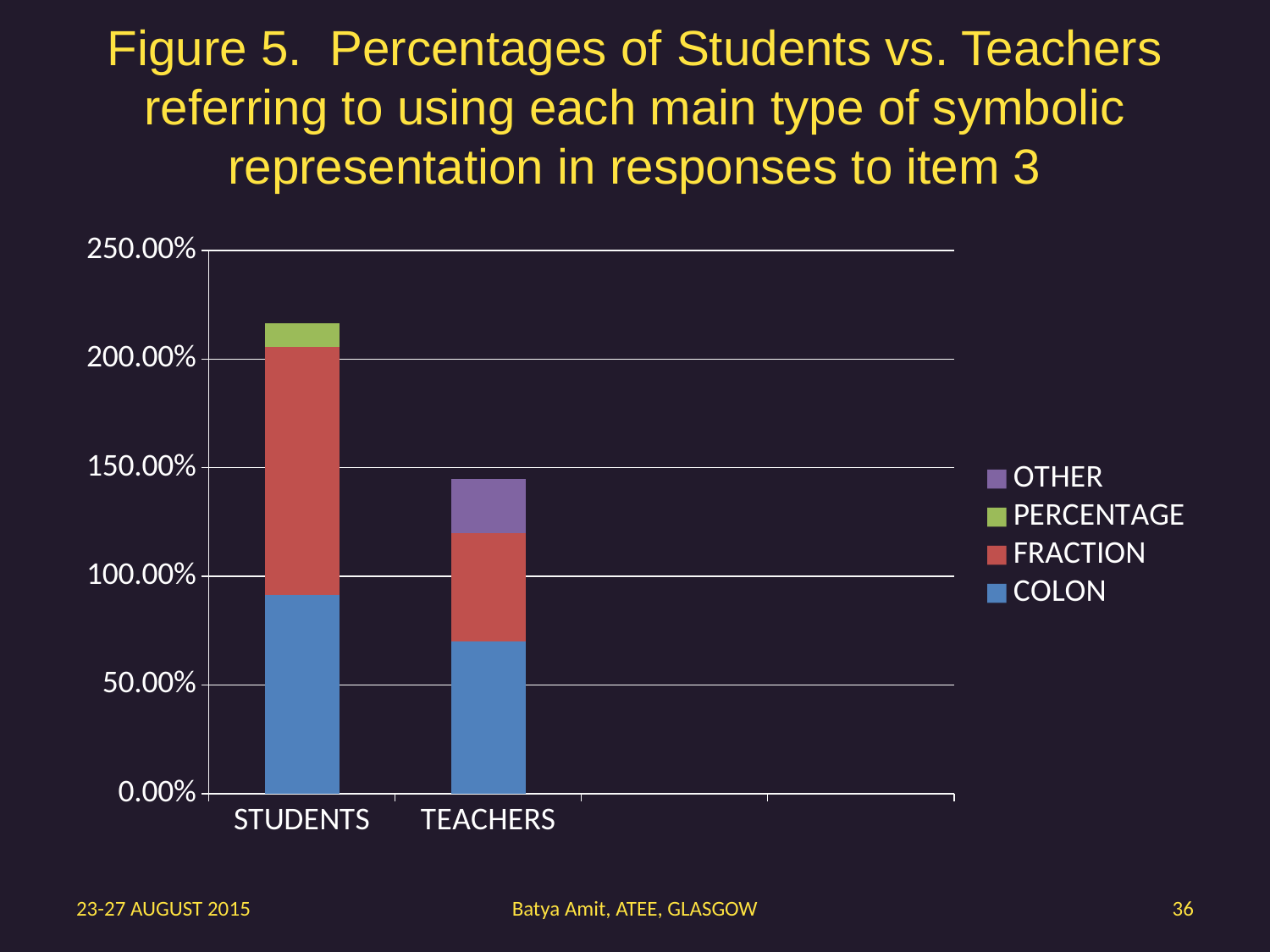
Which category has the larger FRACTION segment, STUDENTS or TEACHERS? STUDENTS What kind of chart is shown on the slide? Stacked bar chart Is the COLON value for STUDENTS greater or less than 100%? less Is the COLON value for TEACHERS greater or less than 50%? greater How many categories are shown on the x axis? 2 How many series does the legend list? 4 Which series appears in the TEACHERS bar but not in the STUDENTS bar? OTHER Which category has the larger COLON segment, STUDENTS or TEACHERS? STUDENTS Which series is shown in blue in the legend? COLON Which category has the taller stacked bar, STUDENTS or TEACHERS? STUDENTS Is the total height of the TEACHERS bar greater or less than 150%? less